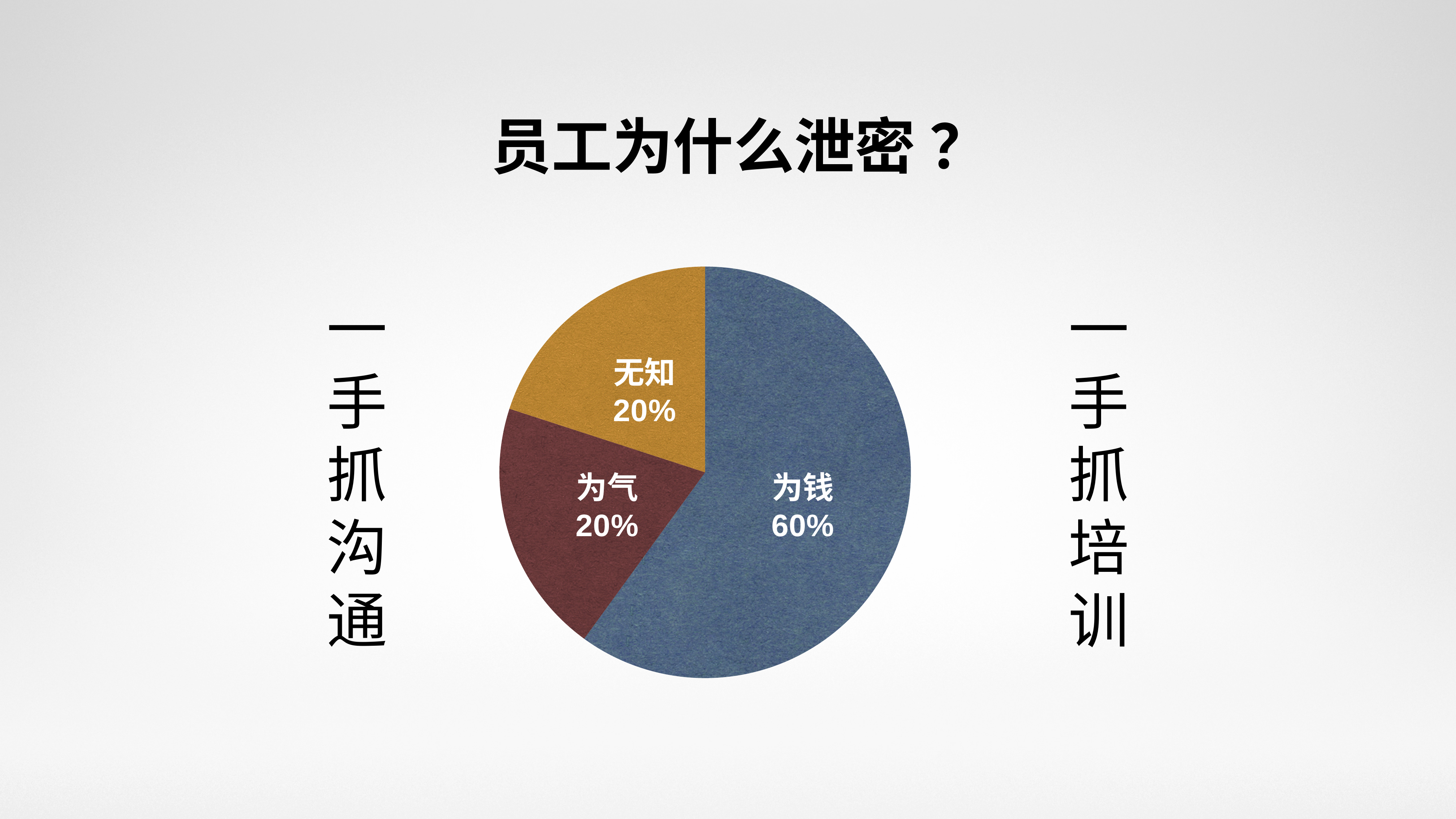
What is the combined share of 为气 and 无知? 40% How many slices does the pie chart have? 3 What is the title of the chart? 员工为什么泄密？ What share of the pie does 为气 take? 20% What colour is the 为钱 slice? blue Which slice of the pie is the largest? 为钱 What kind of chart is shown on the slide? pie chart What share of the pie does 无知 take? 20% What is the difference between the share for 为钱 and the share for 无知? 40% What share of the pie does 为钱 take? 60% Which is larger, the share for 为钱 or the share for 为气? 为钱